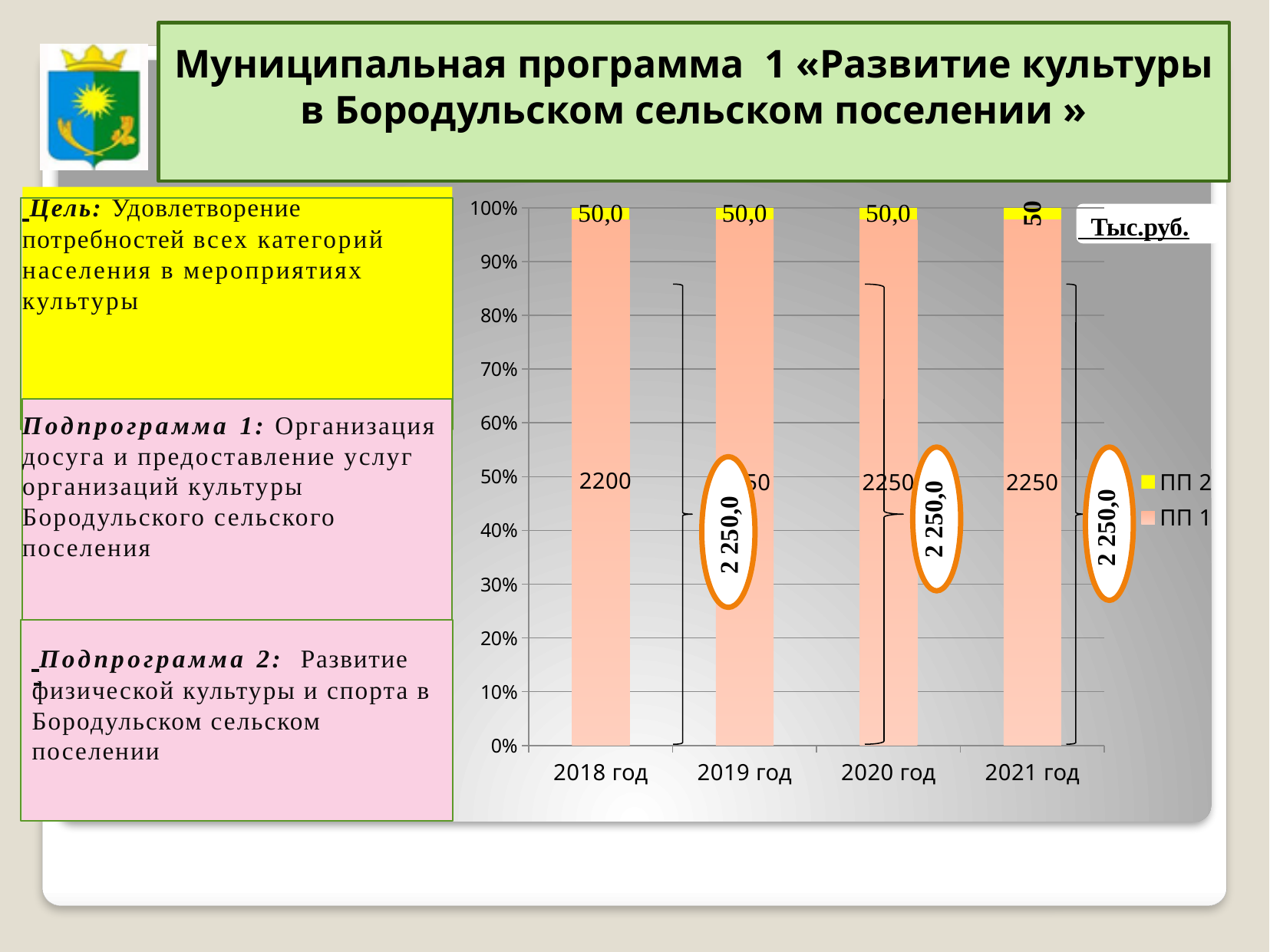
What is the difference between ПП 1 and ПП 2 in 2020 год? 2200 What is the value of ПП 1 for 2018 год? 2200 What is the value of ПП 2 for 2018 год? 50,0 How many series does the chart legend list? 2 What is the value of ПП 1 for 2021 год? 2250 What unit of measurement is indicated in the box at the top right of the chart? Тыс.руб. What is the value of ПП 2 for 2020 год? 50,0 What is the value of ПП 1 for 2020 год? 2250 What kind of chart is shown on the slide? stacked bar chart Which series has the larger value in 2018 год, ПП 1 or ПП 2? ПП 1 How many year categories are shown on the x axis of the chart? 4 By how much does ПП 1 in 2020 год exceed ПП 1 in 2018 год? 50